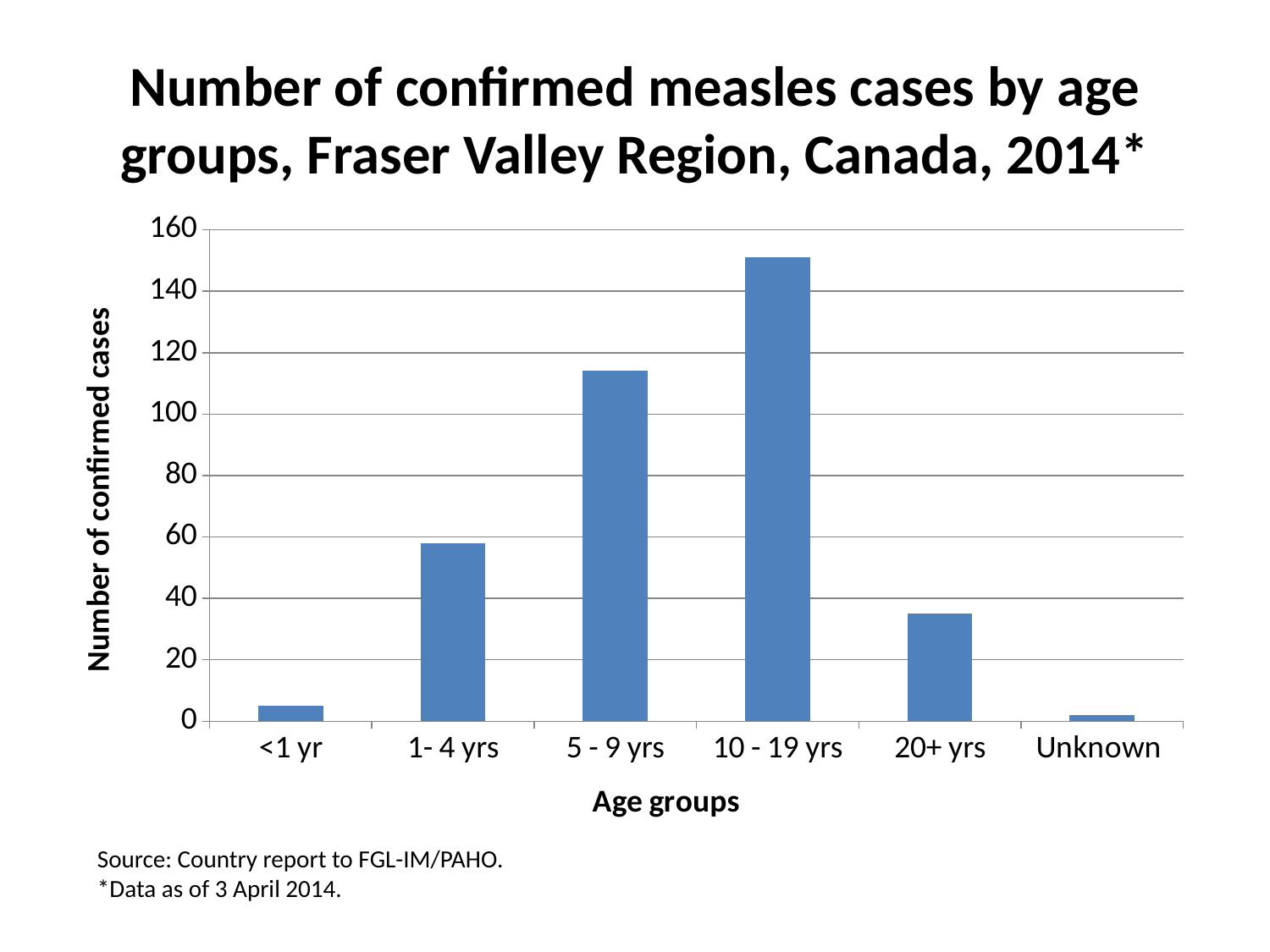
How many age groups are shown on the x axis? 6 Is the value for <1 yr greater or less than 20? less Which age group has the lowest number of confirmed measles cases? Unknown Is the value for 5 - 9 yrs greater or less than 100? greater Which has more confirmed cases, 1- 4 yrs or 20+ yrs? 1- 4 yrs What type of chart is shown on the slide? bar chart Which age group has the highest number of confirmed measles cases? 10 - 19 yrs Is the value for 10 - 19 yrs greater or less than 140? greater Which has more confirmed cases, 5 - 9 yrs or 10 - 19 yrs? 10 - 19 yrs What is the label of the y axis? Number of confirmed cases